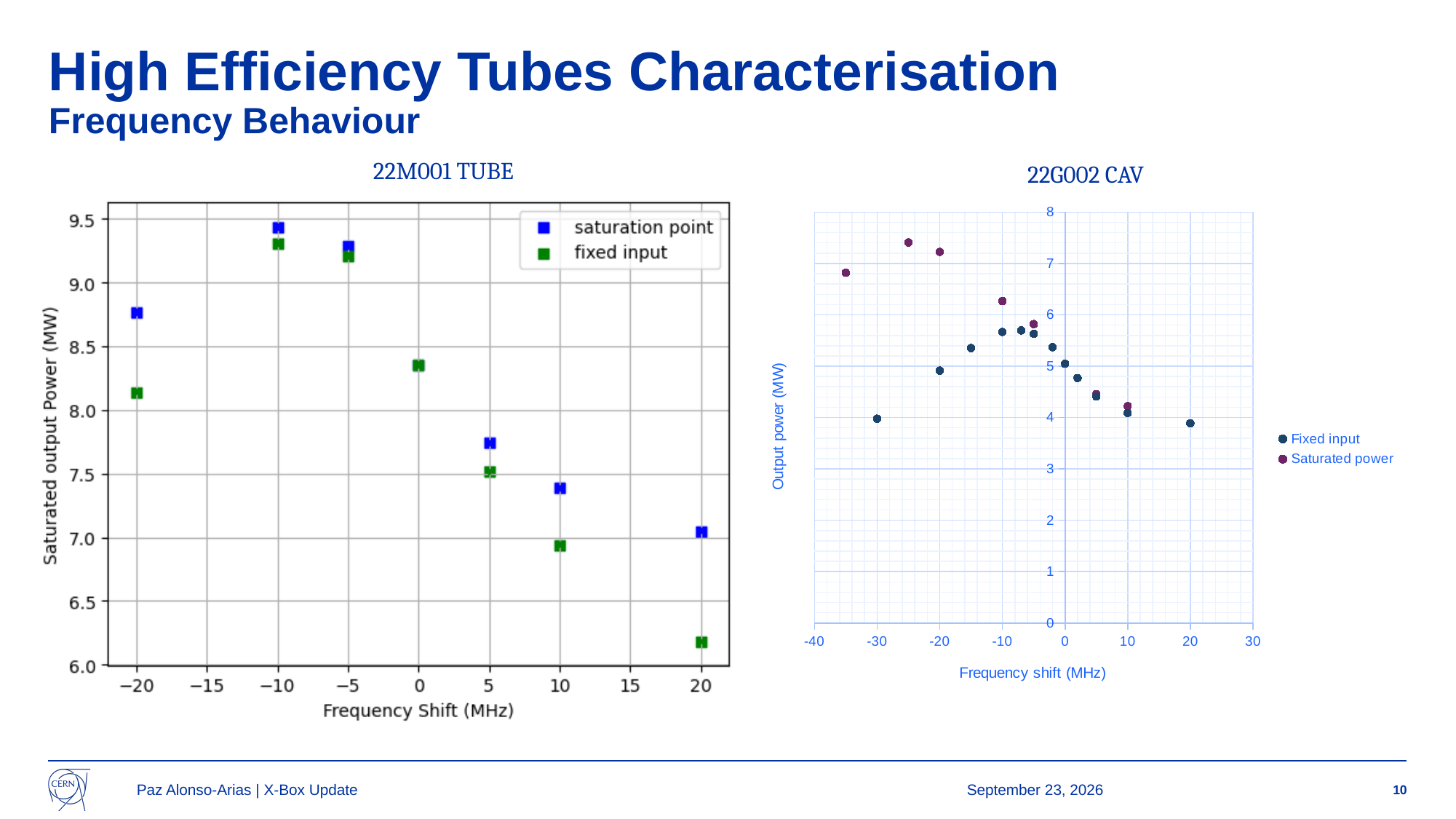
On the 22M001 TUBE chart, do the saturation point values rise or fall as the frequency shift goes from 0 to 20 MHz? fall On the 22M001 TUBE chart, how many series does the legend list? 2 On the 22G002 CAV chart, what are the legend entries? Fixed input, Saturated power On the 22M001 TUBE chart, is the saturation point value at -20 MHz greater or less than 8.5? greater On the 22G002 CAV chart, is the Saturated power value at -25 MHz greater or less than 7? greater On the 22M001 TUBE chart, at which frequency shift is the saturation point highest? -10 MHz On the 22G002 CAV chart, what is the y-axis title? Output power (MW) On the 22M001 TUBE chart, is the fixed input value at 20 MHz greater or less than 6.5? less On the 22M001 TUBE chart, at which frequency shift is the fixed input value lowest? 20 MHz On the 22M001 TUBE chart, at 10 MHz, which is larger: saturation point or fixed input? saturation point On the 22G002 CAV chart, how many series does the legend list? 2 On the 22M001 TUBE chart, what kind of chart is shown? scatter chart